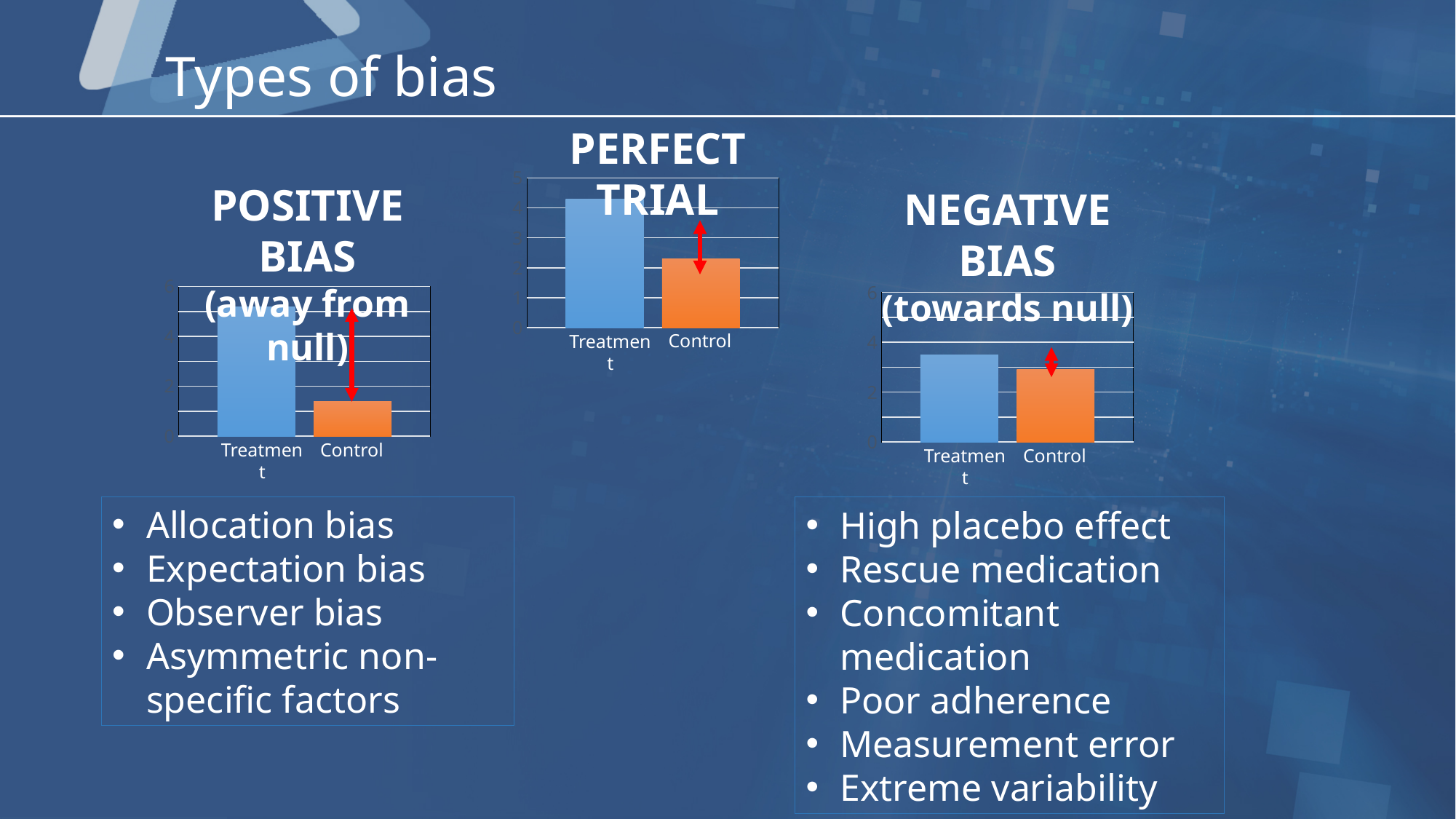
How many charts are shown on the slide? 3 What colour is the Control bar in the PERFECT TRIAL chart? orange In the POSITIVE BIAS chart, which bar is taller, Treatment or Control? Treatment In the NEGATIVE BIAS chart, which category has the lowest value? Control In the PERFECT TRIAL chart, which category has the highest value? Treatment What kind of chart is the PERFECT TRIAL chart? bar chart In the NEGATIVE BIAS chart, which is larger, the Treatment bar or the Control bar? Treatment In the NEGATIVE BIAS chart, is the value for Control greater or less than 2? greater What kind of chart is the POSITIVE BIAS chart? bar chart In the POSITIVE BIAS chart, which category has the lowest value? Control How many categories are shown on the x axis of the PERFECT TRIAL chart? 2